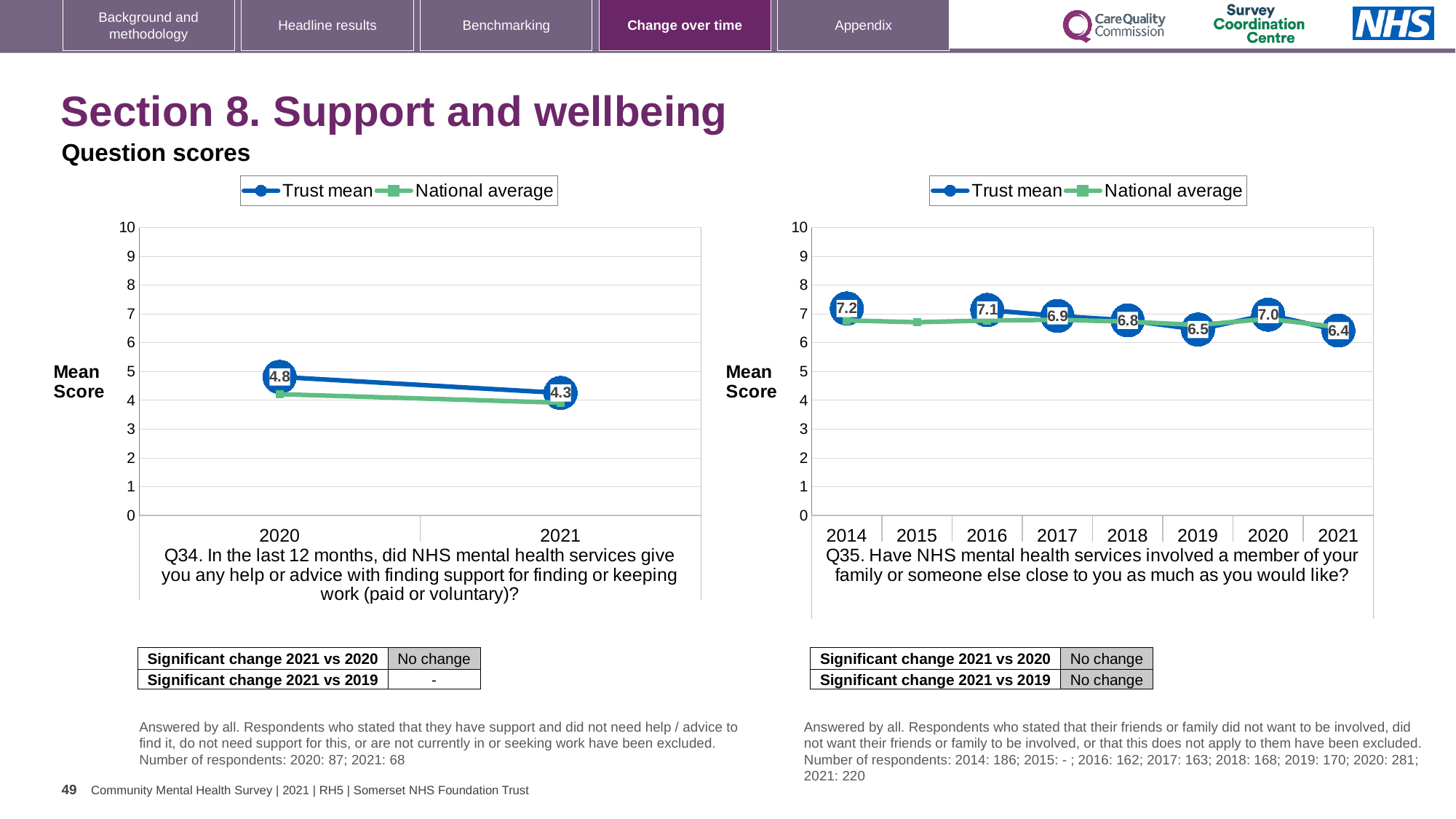
In the Q35 chart on the right, is the Trust mean higher in 2020 or in 2021? 2020 What kind of chart is the Q34 chart on the left? line chart In the Q35 chart on the right, what is the Trust mean for 2014? 7.2 In the Q34 chart on the left, what is the difference between the Trust mean in 2020 and in 2021? 0.5 How many series does the legend of the Q35 chart on the right list? 2 In the Q34 chart on the left, what is the Trust mean for 2020? 4.8 In the Q35 chart on the right, what is the Trust mean for 2021? 6.4 In the Q35 chart on the right, which year has the lowest labelled Trust mean? 2021 In the Q35 chart on the right, which year has the highest labelled Trust mean? 2014 In the Q35 chart on the right, what is the Trust mean for 2019? 6.5 In the Q34 chart on the left, what is the Trust mean for 2021? 4.3 In the Q34 chart on the left, does the Trust mean rise or fall from 2020 to 2021? fall